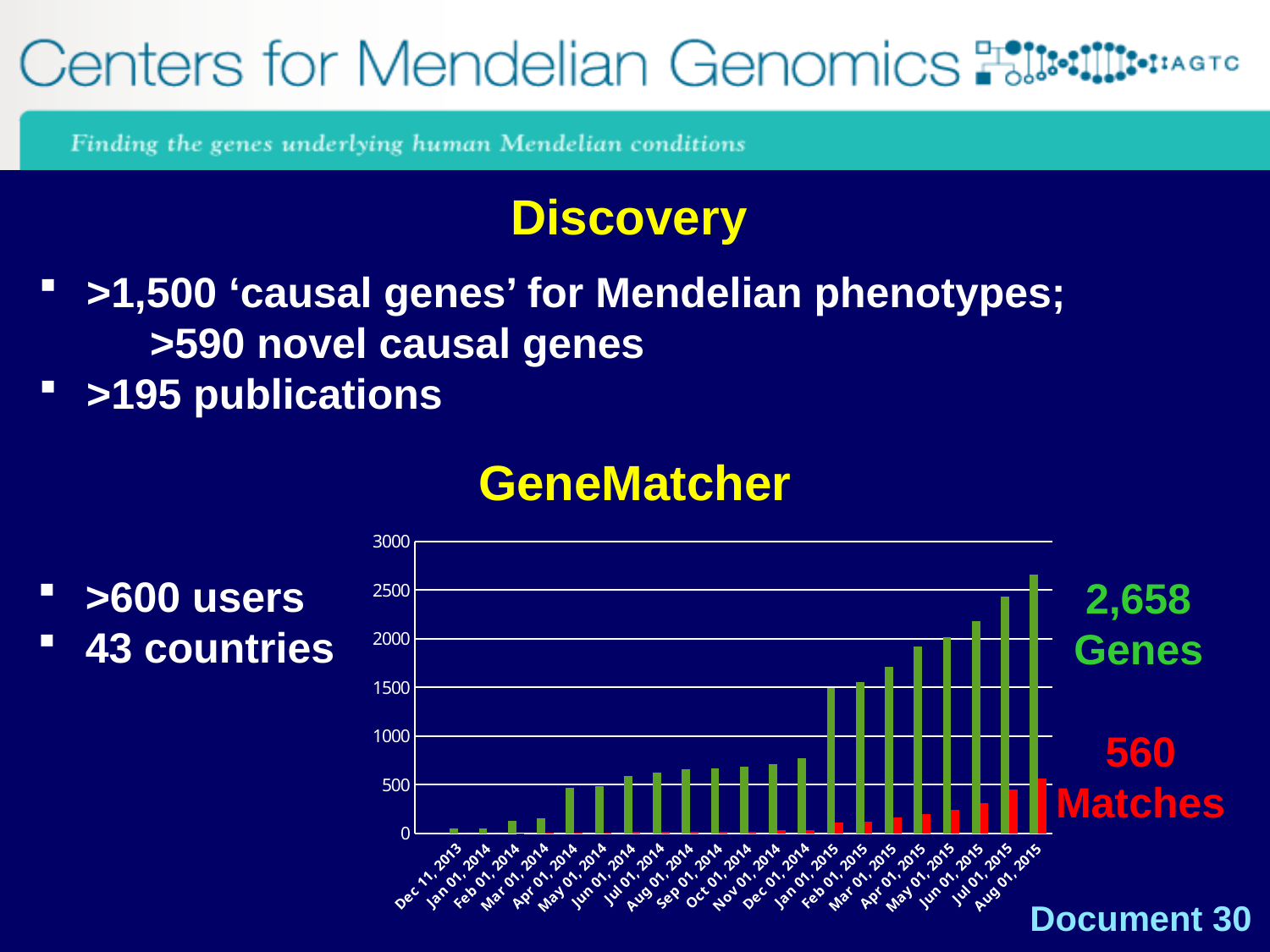
What is the number of Matches shown for the final bar (Aug 01, 2015) in the GeneMatcher chart? 560 What is the difference between the 2,658 Genes and the 560 Matches labelled on the GeneMatcher chart? 2,098 What kind of chart is shown under the GeneMatcher heading? bar chart What colour are the bars representing Matches in the GeneMatcher chart? red What is the number of Genes shown for the final bar (Aug 01, 2015) in the GeneMatcher chart? 2,658 Is the green Genes bar for Dec 01, 2014 greater or less than 1000? less Is the green Genes bar for Jan 01, 2015 greater or less than 1000? greater How many dates are shown along the x axis of the GeneMatcher chart? 21 Do the green Genes bars rise or fall from Dec 11, 2013 to Aug 01, 2015? rise Is the green Genes bar for Mar 01, 2014 greater or less than 500? less At Aug 01, 2015, which is larger: the Genes bar or the Matches bar? Genes Which date has the highest green Genes bar in the GeneMatcher chart? Aug 01, 2015